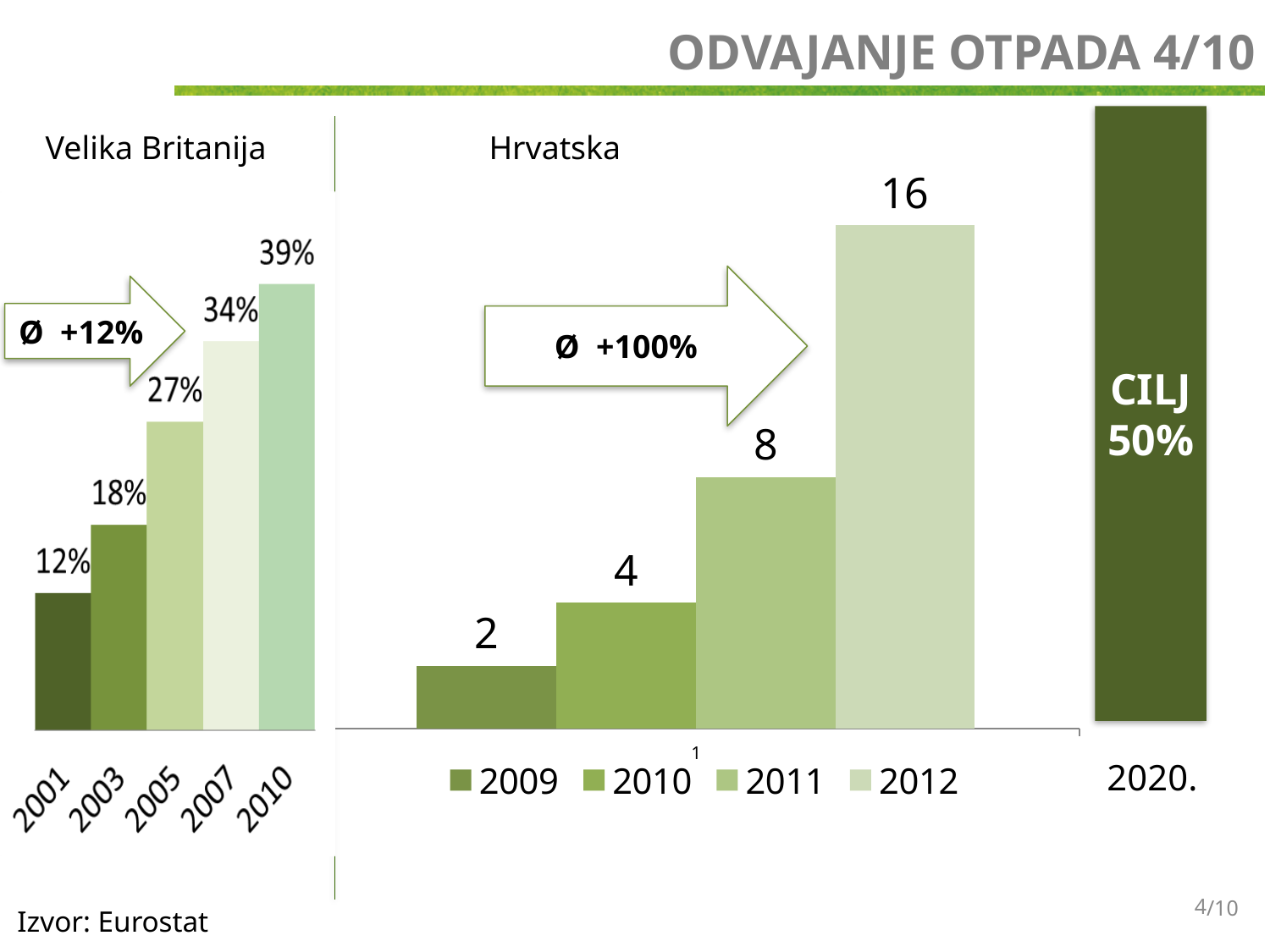
In the Velika Britanija chart, what is the value for 2010? 39% In the Velika Britanija chart, what is the difference between the values for 2010 and 2001? 27% In the Velika Britanija chart, do the values rise or fall from 2001 to 2010? rise What is the target (CILJ) value shown for 2020 on the slide? 50% In the Hrvatska chart, what is the difference between the values for 2012 and 2010? 12 In the Hrvatska chart, what is the value for 2011? 8 In the Velika Britanija chart, what is the value for 2005? 27% In the Velika Britanija chart, how many bars are shown? 5 In the Hrvatska chart, which year has the highest value? 2012 What kind of chart is the Hrvatska chart? bar chart In the Velika Britanija chart, which year has the lowest value? 2001 In the Hrvatska chart, how many entries does the legend list? 4